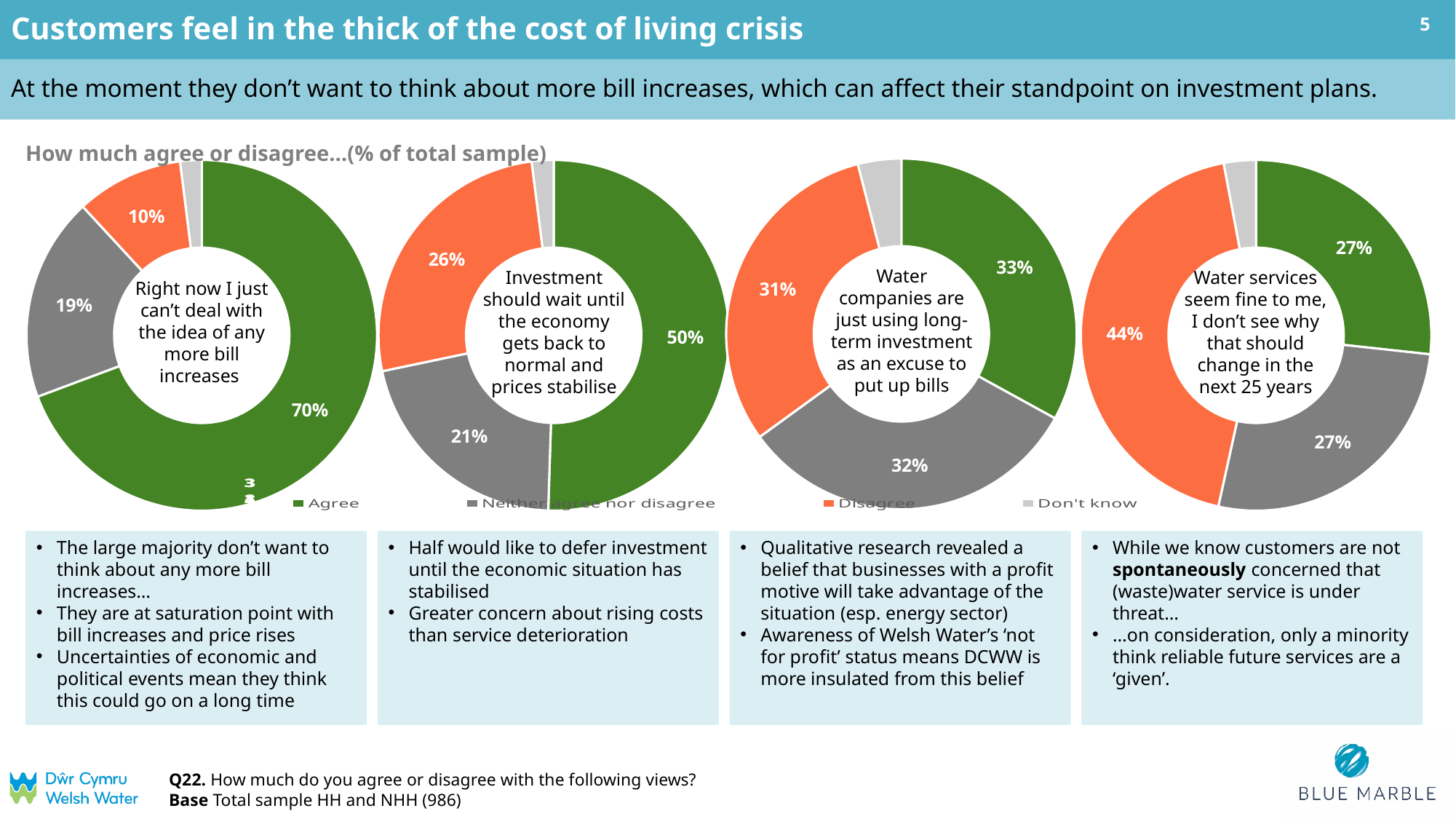
In the donut chart 'Water companies are just using long-term investment as an excuse to put up bills', what percentage disagree? 31% In the donut chart 'Water services seem fine to me, I don't see why that should change in the next 25 years', what is the difference between the Disagree and Agree percentages? 17% In the donut chart 'Right now I just can't deal with the idea of any more bill increases', what is the difference between the Agree and Neither agree nor disagree percentages? 51% How many response categories does the legend list? 4 In the donut chart 'Investment should wait until the economy gets back to normal and prices stabilise', which is larger: Disagree or Neither agree nor disagree? Disagree In the donut chart 'Right now I just can't deal with the idea of any more bill increases', what percentage agree? 70% In the donut chart 'Right now I just can't deal with the idea of any more bill increases', what percentage disagree? 10% In the donut chart 'Investment should wait until the economy gets back to normal and prices stabilise', what percentage neither agree nor disagree? 21% What type of chart is used to show the responses on this slide? Donut (pie) chart Which colour represents 'Disagree' in the legend? Orange In the donut chart 'Water services seem fine to me, I don't see why that should change in the next 25 years', which response has the largest share? Disagree In the donut chart 'Investment should wait until the economy gets back to normal and prices stabilise', what percentage agree? 50%